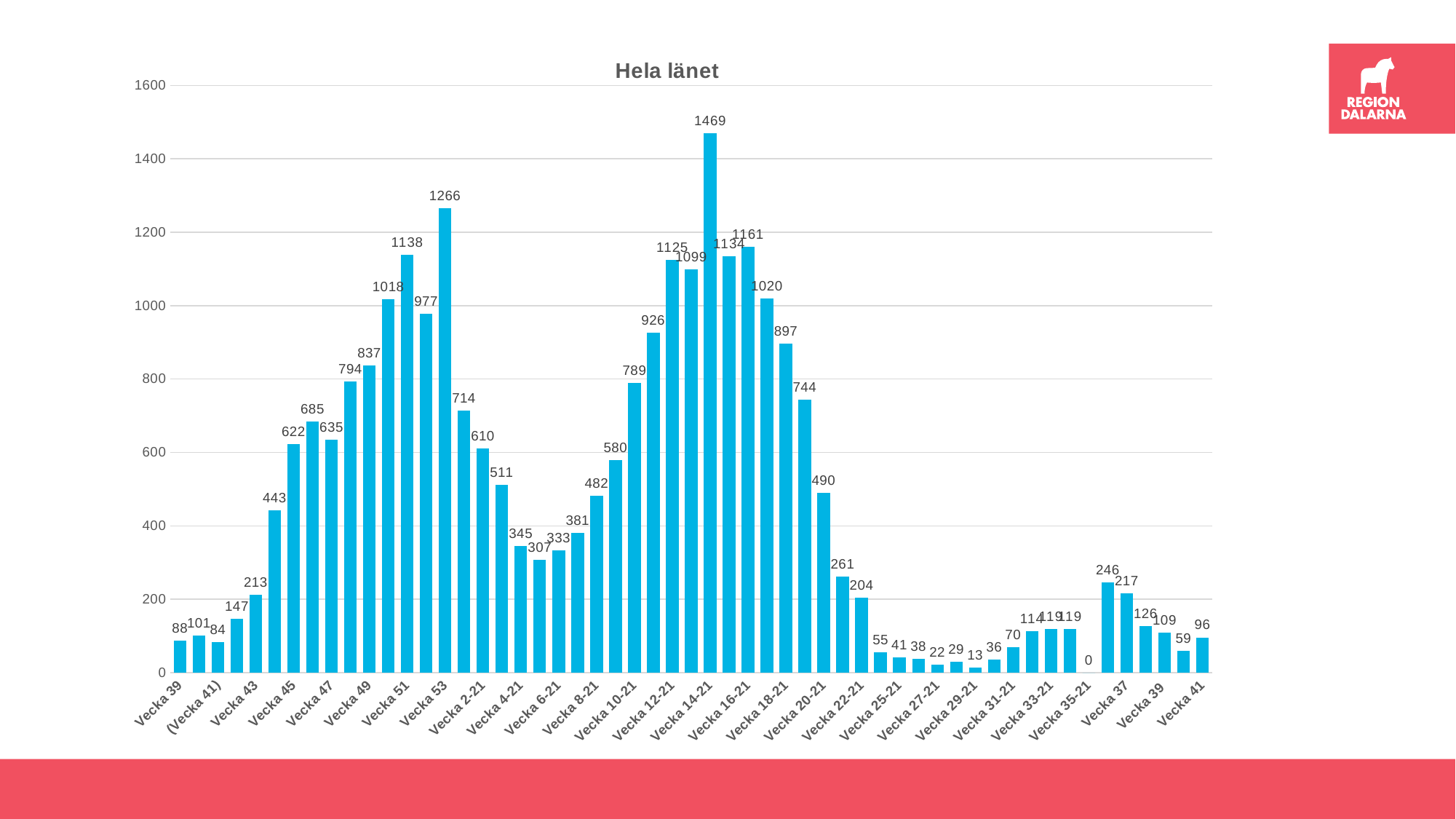
What is the value for Vecka 41, the last bar in the chart? 96 Is the value for Vecka 14-21 greater or less than 1400? greater What is the value for Vecka 39, the first bar in the chart? 88 What is the difference between the values for Vecka 14-21 and Vecka 53? 203 Which week has the highest value in the chart? Vecka 14-21 What is the value for Vecka 35-21? 0 What is the title of the chart? Hela länet What is the value for Vecka 14-21? 1469 What kind of chart is shown on the slide? Bar chart Which week has the lowest value in the chart? Vecka 35-21 Which is larger, the value for Vecka 53 or the value for Vecka 51? Vecka 53 What is the value for Vecka 53? 1266